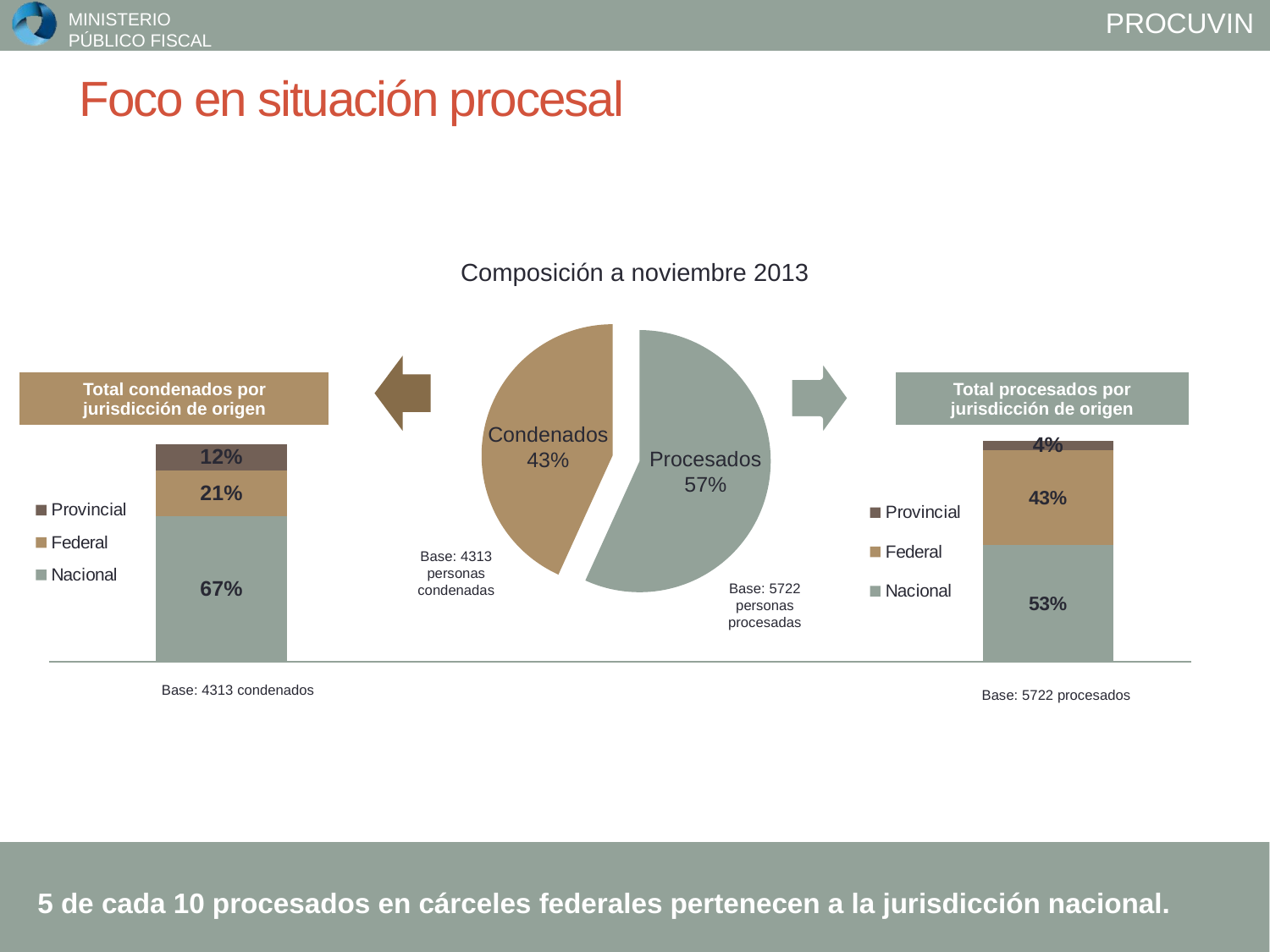
In the pie chart titled 'Composición a noviembre 2013', which slice is larger, Condenados or Procesados? Procesados In the pie chart titled 'Composición a noviembre 2013', what share is labelled for Procesados? 57% In the pie chart titled 'Composición a noviembre 2013', how many slices are there? 2 In the chart titled 'Total condenados por jurisdicción de origen', which jurisdiction has the lowest value? Provincial How many entries does the legend of the chart titled 'Total procesados por jurisdicción de origen' list? 3 In the chart titled 'Total condenados por jurisdicción de origen', what is the difference between the Nacional and Federal values? 46% In the chart titled 'Total condenados por jurisdicción de origen', what is the value for Nacional? 67% In the chart titled 'Total condenados por jurisdicción de origen', what is the value for Provincial? 12% In the chart titled 'Total procesados por jurisdicción de origen', what is the value for Federal? 43% In the chart titled 'Total procesados por jurisdicción de origen', which jurisdiction has the highest value? Nacional In the chart titled 'Total procesados por jurisdicción de origen', what is the difference between the Nacional and Provincial values? 49% In the pie chart titled 'Composición a noviembre 2013', what share is labelled for Condenados? 43%